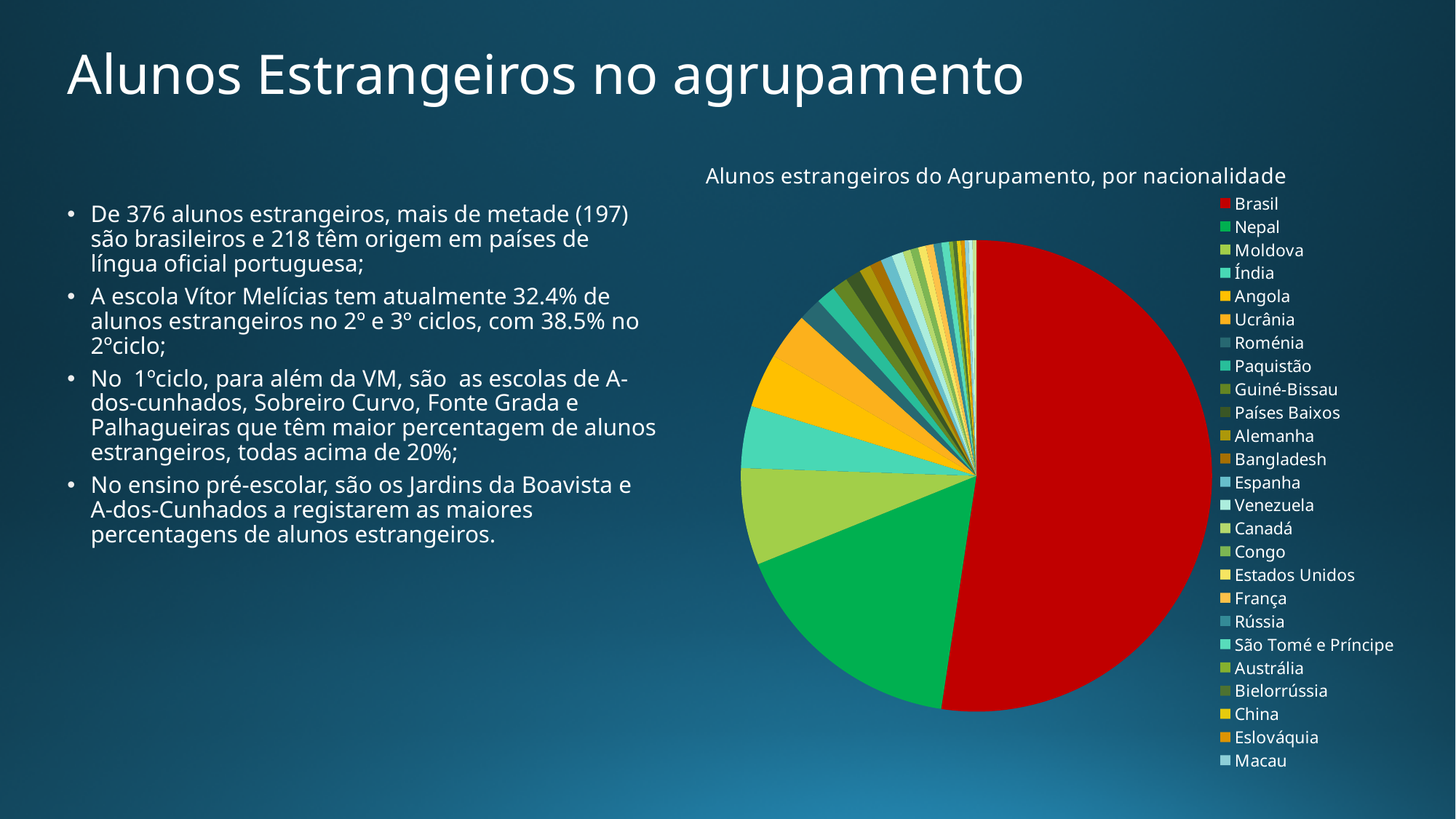
What is the title of the chart? Alunos estrangeiros do Agrupamento, por nacionalidade Which nationality has the largest slice of the pie? Brasil What kind of chart is shown on the slide? pie chart Which slice is larger, Moldova or Angola? Moldova What colour is the Brasil slice in the pie chart? red Which slice is larger, Brasil or Nepal? Brasil Which slice is larger, Nepal or Moldova? Nepal How many nationalities are listed in the chart legend? 25 Which nationality has the second largest slice of the pie? Nepal Which nationality is listed first in the legend? Brasil